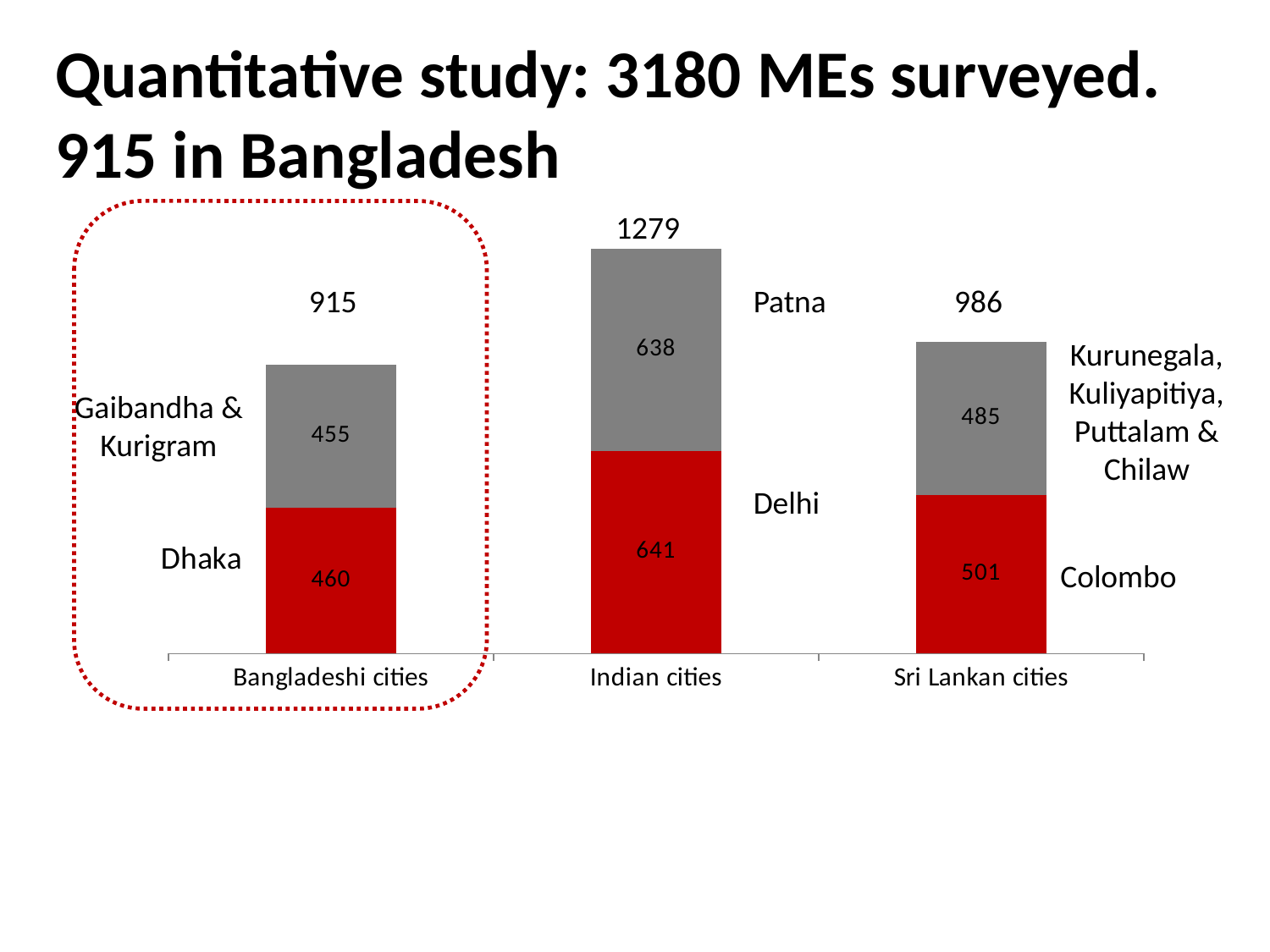
Which city group has the highest total number of MEs surveyed? Indian cities What kind of chart is shown on the slide? Stacked bar chart What is the value labelled for Dhaka in the Bangladeshi cities bar? 460 How many city groups are shown on the x axis of the chart? 3 What is the value labelled for Colombo in the Sri Lankan cities bar? 501 What is the value labelled for Gaibandha & Kurigram in the Bangladeshi cities bar? 455 What is the total shown above the Sri Lankan cities bar? 986 What is the total shown above the Indian cities bar? 1279 What is the difference between the Indian cities total and the Bangladeshi cities total? 364 What is the value labelled for Patna in the Indian cities bar? 638 Which city group has the lowest total number of MEs surveyed? Bangladeshi cities What is the value labelled for Delhi in the Indian cities bar? 641